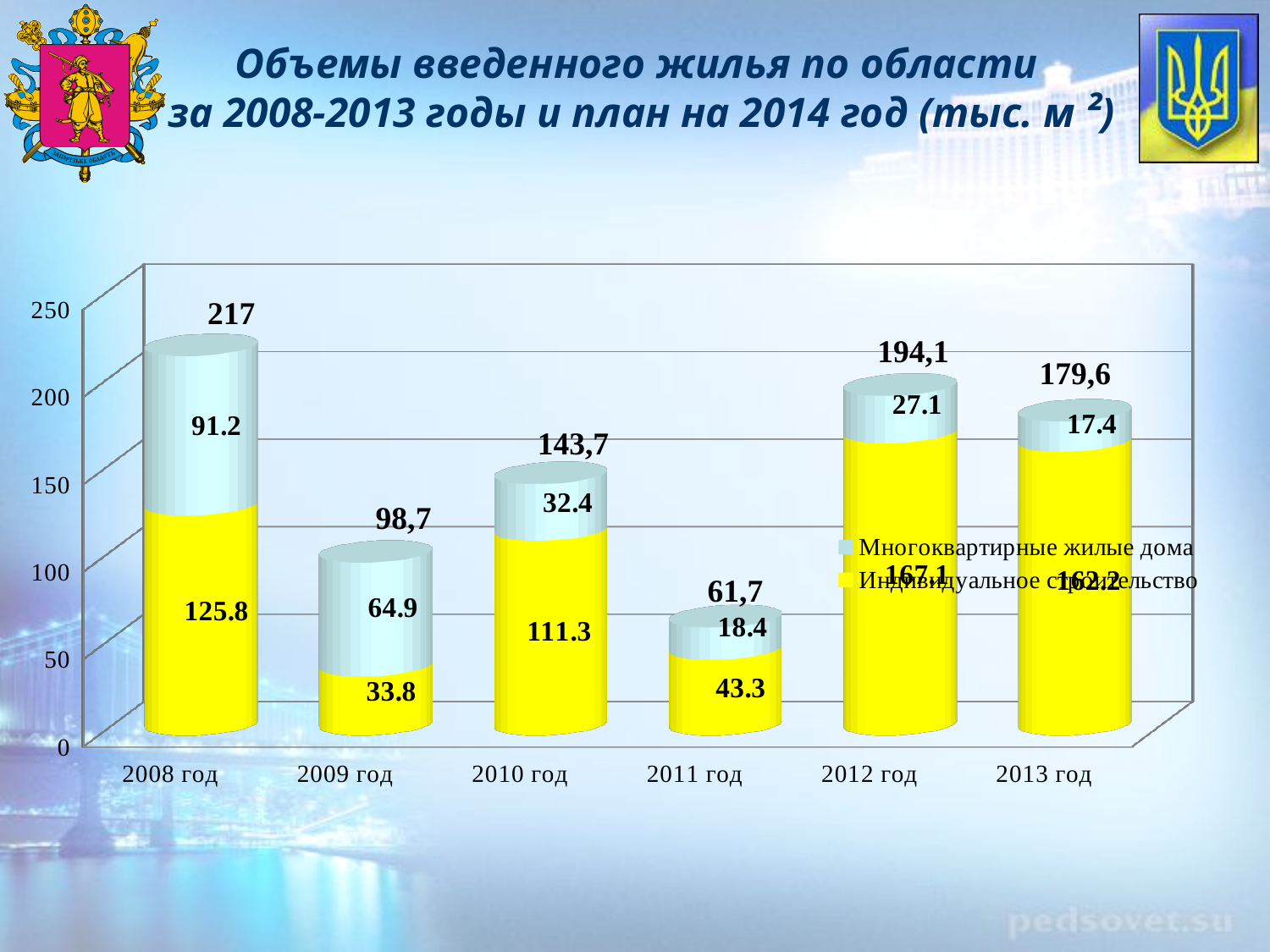
In 2010 год, which is larger: Многоквартирные жилые дома or Индивидуальное строительство? Индивидуальное строительство How many series does the legend list? 2 What is the total of the stacked bar for 2008 год? 217 What is the total of the stacked bar for 2013 год? 179,6 What is the value for Многоквартирные жилые дома in 2008 год? 91.2 Which year has the lowest total volume? 2011 год What is the value for Многоквартирные жилые дома in 2011 год? 18.4 In 2009 год, how much larger is Многоквартирные жилые дома than Индивидуальное строительство? 31.1 Which year has the highest total volume? 2008 год How many years are shown on the x axis? 6 What is the value for Индивидуальное строительство in 2010 год? 111.3 What kind of chart is shown on the slide? Stacked bar chart